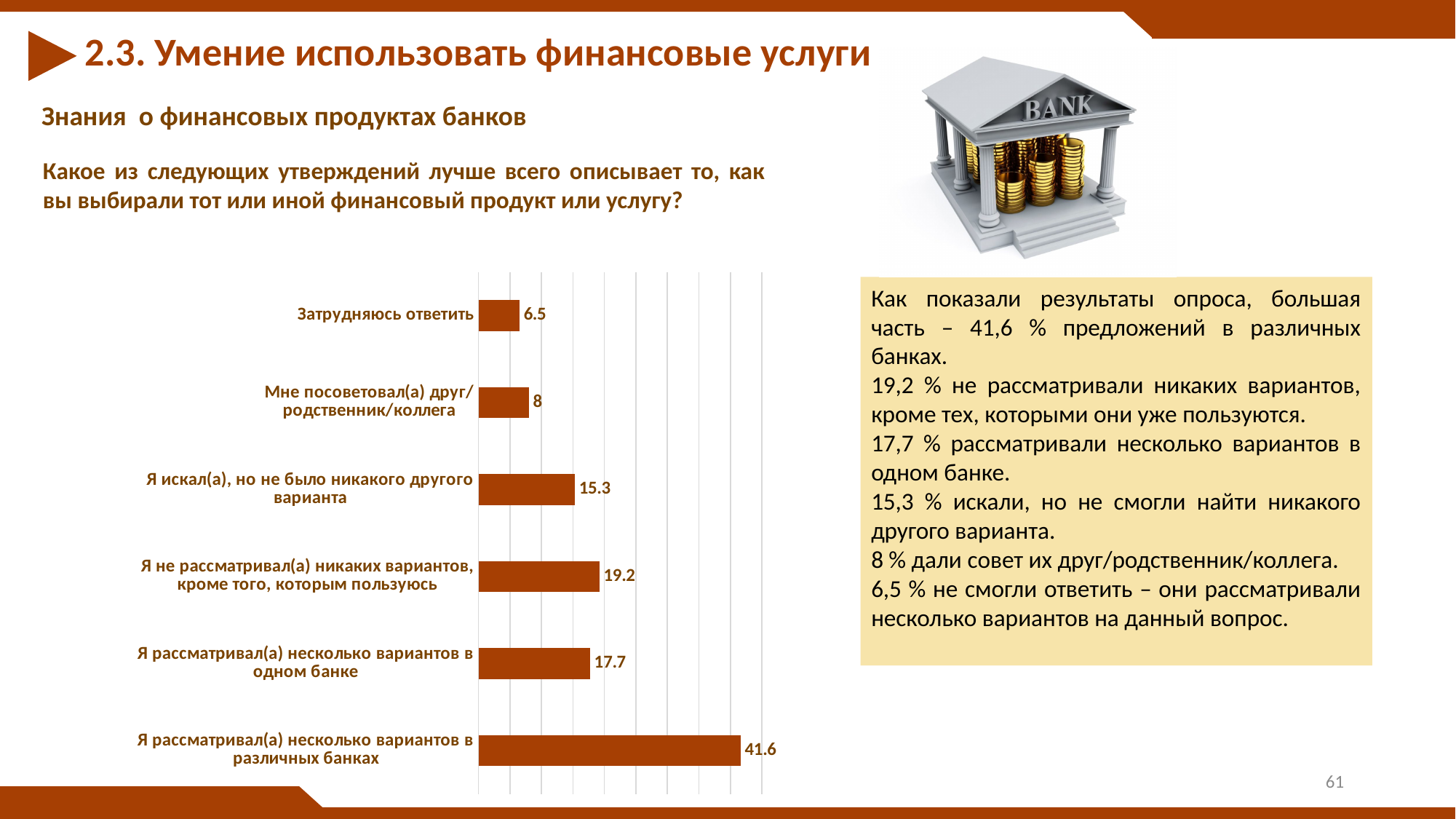
What kind of chart is shown on the slide? Bar chart What value is shown for "Затрудняюсь ответить"? 6.5 Which category has the highest value? Я рассматривал(а) несколько вариантов в различных банках What value is shown for "Я рассматривал(а) несколько вариантов в различных банках"? 41.6 Which is larger: the value for "Я искал(а), но не было никакого другого варианта" or the value for "Мне посоветовал(а) друг/родственник/коллега"? Я искал(а), но не было никакого другого варианта What value is shown for "Мне посоветовал(а) друг/родственник/коллега"? 8 What is the difference between the values for "Я не рассматривал(а) никаких вариантов, кроме того, которым пользуюсь" and "Я рассматривал(а) несколько вариантов в одном банке"? 1.5 What value is shown for "Я рассматривал(а) несколько вариантов в одном банке"? 17.7 Which category has the lowest value? Затрудняюсь ответить What colour are the bars in the chart? Brown (dark orange) How many categories are shown in the chart? 6 What is the difference between the values for "Я рассматривал(а) несколько вариантов в различных банках" and "Я искал(а), но не было никакого другого варианта"? 26.3